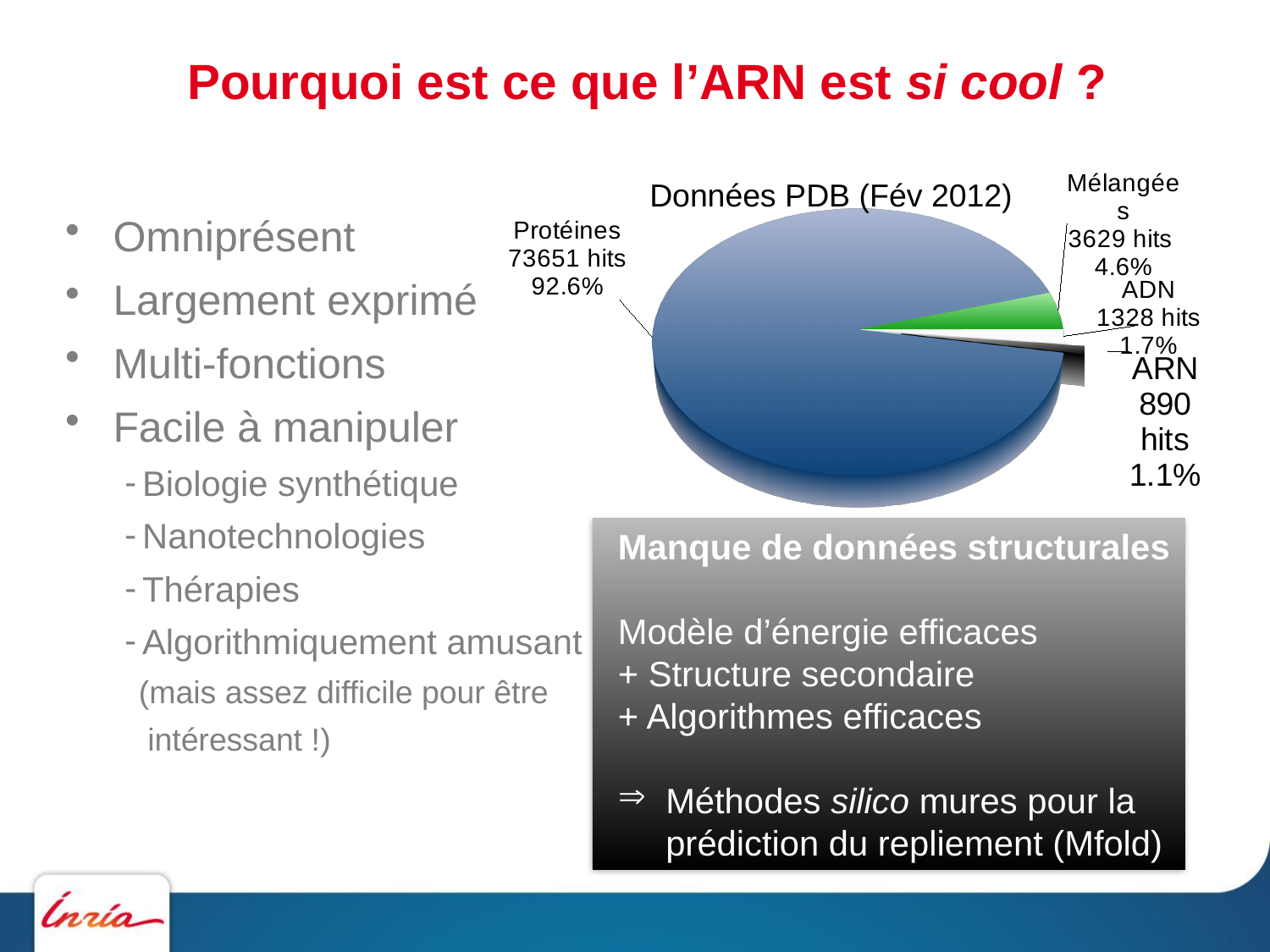
What share of the pie does ARN represent? 1.1% How many hits are shown for ARN? 890 hits What percentage of the pie does Protéines represent? 92.6% Which category has the smallest slice of the pie? ARN What share of the pie does Mélangées represent? 4.6% Which category has the largest slice of the pie? Protéines How many hits are shown for ADN? 1328 hits How many hits are shown for Protéines? 73651 hits What is the difference in hits between ADN and ARN? 438 hits What kind of chart is shown on the slide? pie chart What is the title of the pie chart? Données PDB (Fév 2012) How many slices does the pie chart have? 4